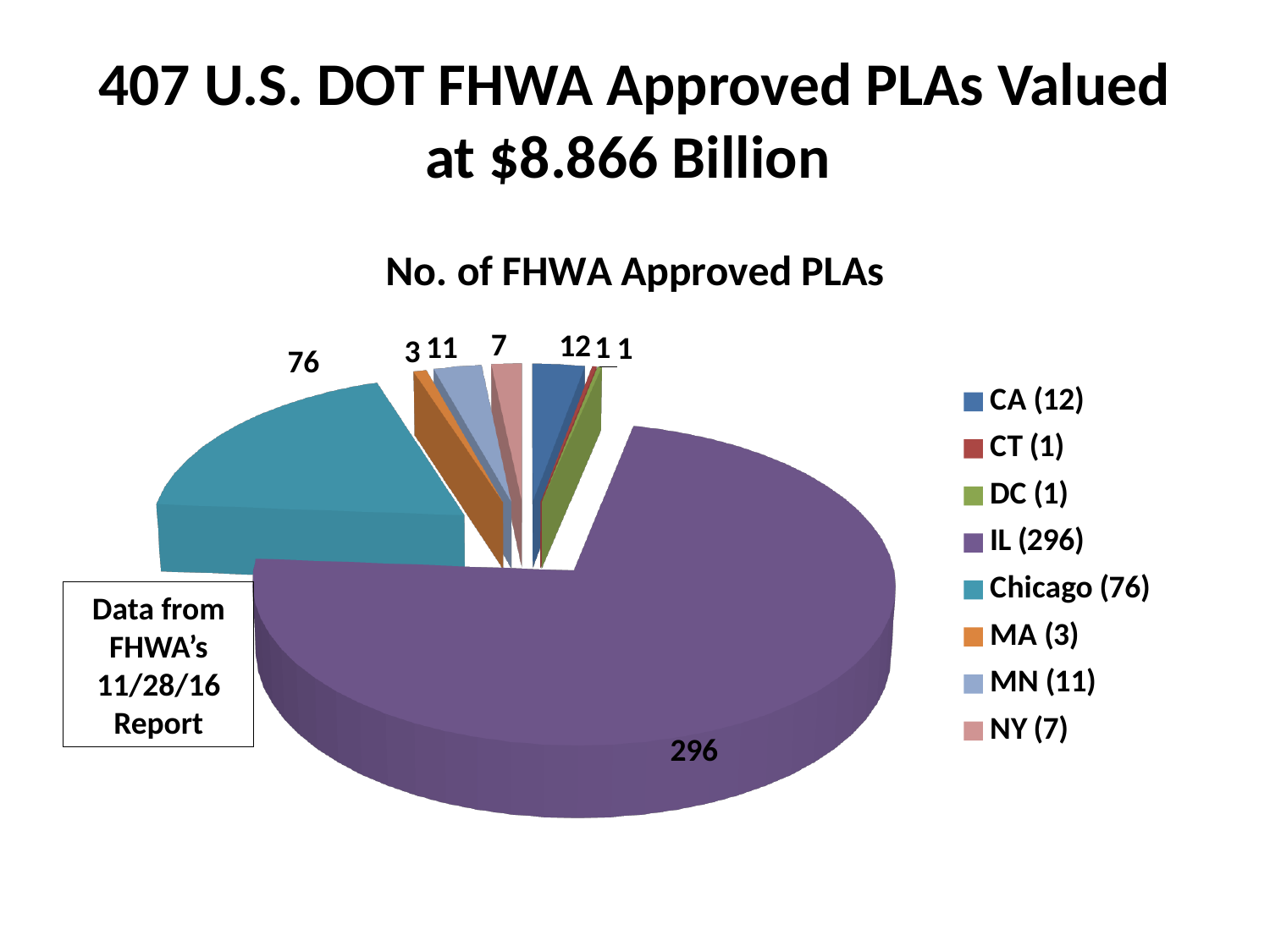
What is the value for MN in the pie chart? 11 How many categories are shown in the pie chart's legend? 8 How much larger is the value for CA than the value for NY? 5 Which is larger, the value for MN or the value for NY? MN What is the difference between the values for IL and Chicago? 220 What is the total of all the slices in the pie chart? 407 What is the title of the chart? No. of FHWA Approved PLAs What is the value for IL in the pie chart? 296 Which category has the largest slice of the pie chart? IL What kind of chart is shown on the slide? pie chart How many FHWA approved PLAs does the chart show for Chicago? 76 Which categories have the smallest value in the pie chart? CT and DC